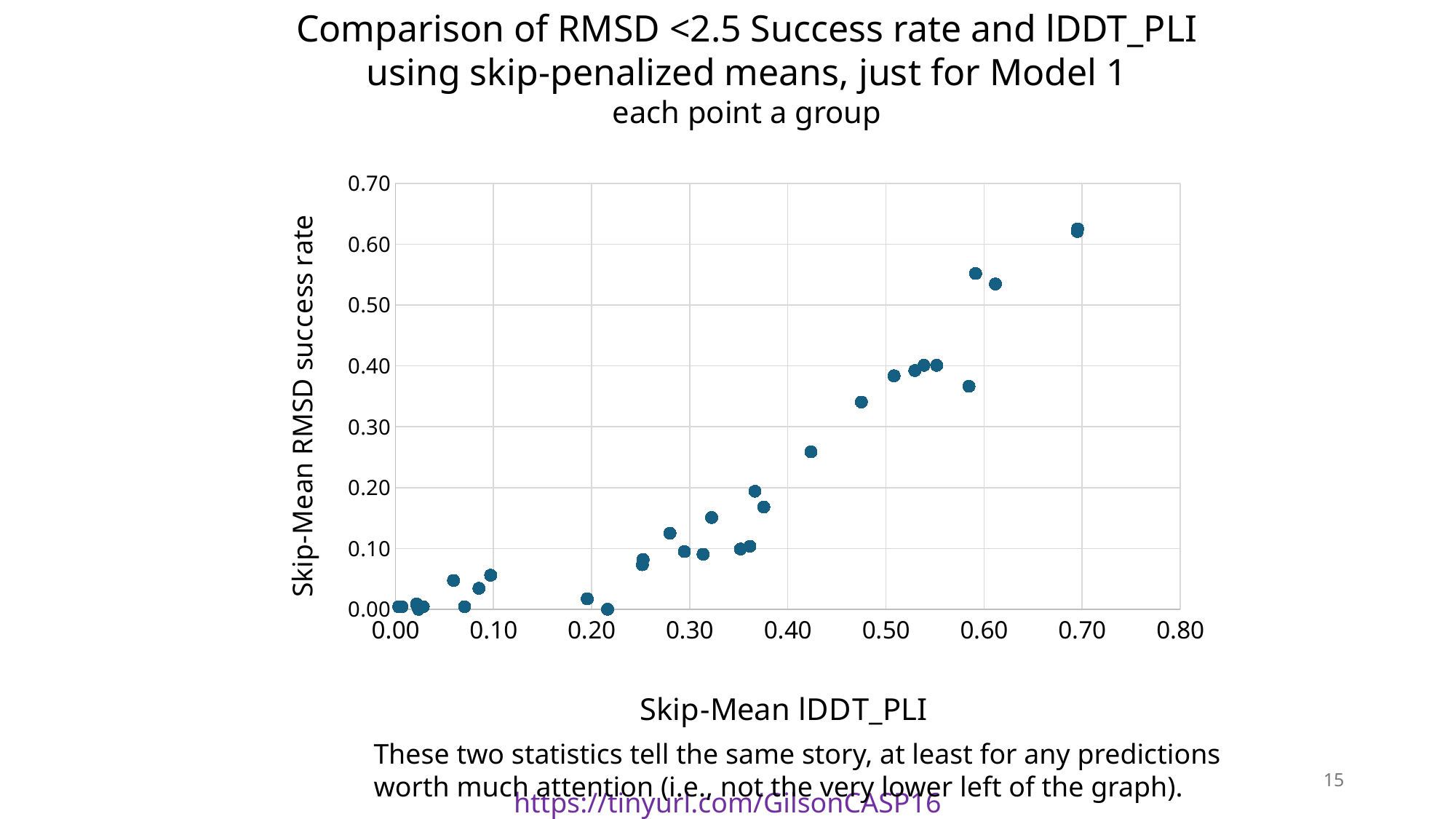
What is the highest tick value shown on the y axis? 0.70 Is the largest Skip-Mean lDDT_PLI value plotted greater or less than 0.80? less Does the point with the largest Skip-Mean lDDT_PLI also have the largest Skip-Mean RMSD success rate? Yes Is the Skip-Mean RMSD success rate of the point near x = 0.42 greater or less than 0.30? less What kind of chart is shown on the slide? Scatter plot Is the Skip-Mean lDDT_PLI value of the rightmost point greater or less than 0.60? greater What is the label of the x axis? Skip-Mean lDDT_PLI As Skip-Mean lDDT_PLI increases along the x axis, do the Skip-Mean RMSD success rate values generally rise or fall? Rise